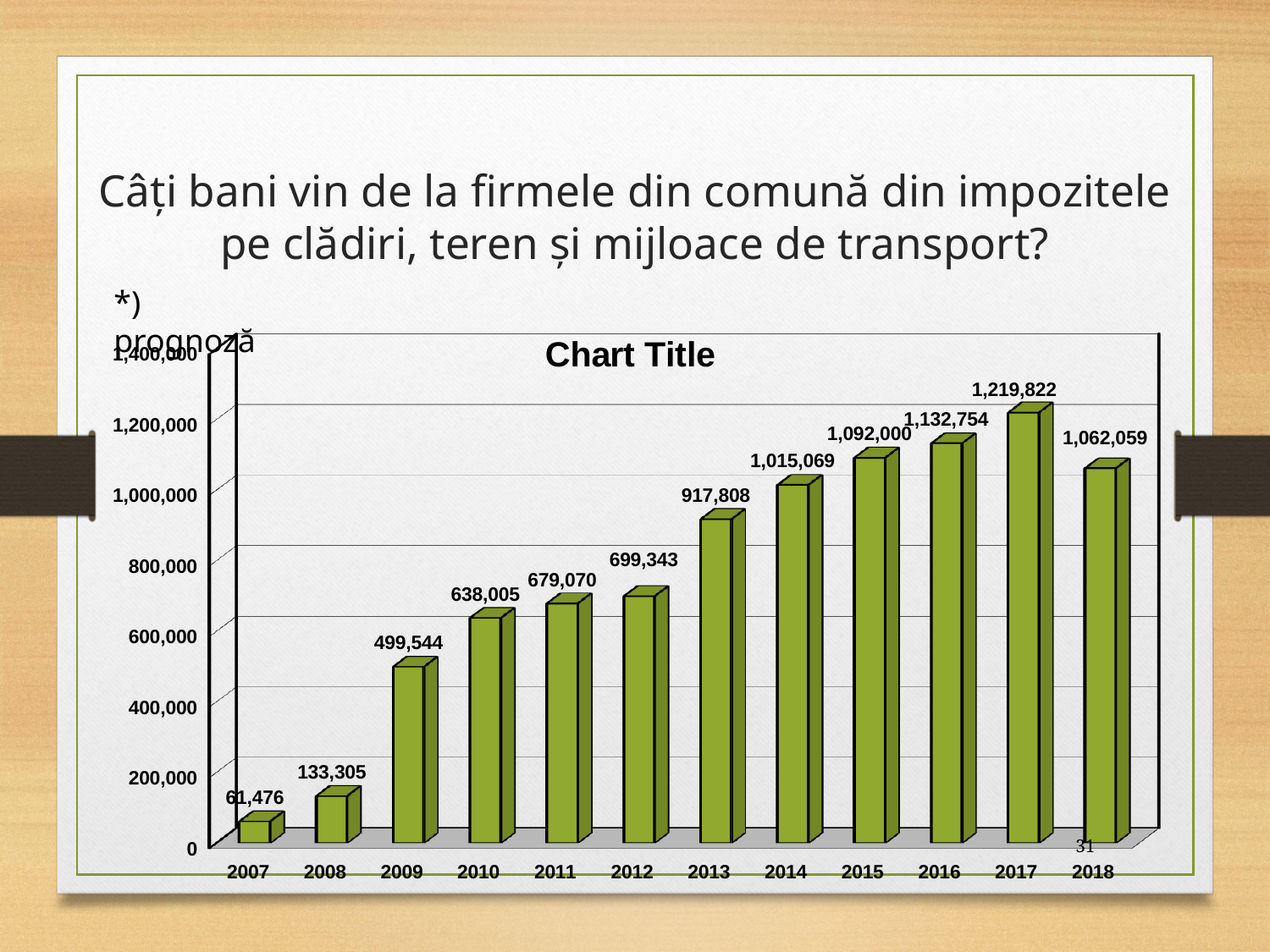
What is the value for 2013? 917,808 Which year has the lowest value? 2007 Which year has the highest value? 2017 What is the value for 2009? 499,544 What is the value for 2018? 1,062,059 Do the values rise or fall from 2007 to 2017? rise What kind of chart is shown on the slide? bar chart What is the difference between the values for 2012 and 2011? 20,273 What is the difference between the values for 2017 and 2016? 87,068 How many years are shown on the x axis? 12 Which is larger, the value for 2018 or the value for 2015? 2015 Is the value for 2013 greater or less than 800,000? greater